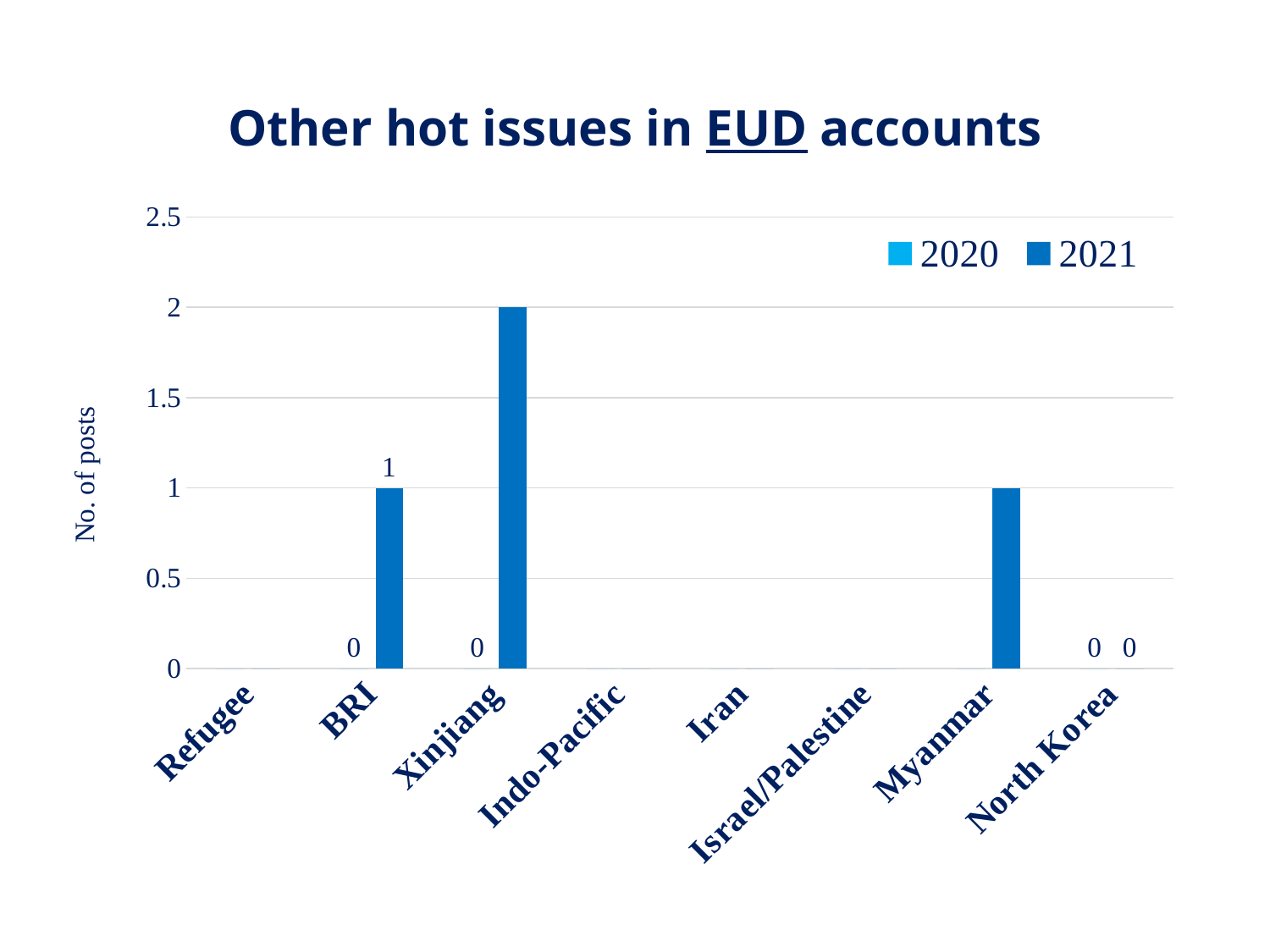
Which has more posts in 2021, Xinjiang or BRI? Xinjiang What is the difference between the 2021 posts for Xinjiang and for BRI? 1 What is the number of posts for Xinjiang in 2021? 2 What kind of chart is shown on the slide? bar chart Is the 2021 value for Xinjiang greater or less than 1.5? greater What is the number of posts for BRI in 2021? 1 Which category has the highest number of posts in 2021? Xinjiang What is the title of the y axis? No. of posts How many series does the legend list? 2 What is the number of posts for Myanmar in 2021? 1 What is the number of posts for BRI in 2020? 0 How many categories are shown on the x axis? 8